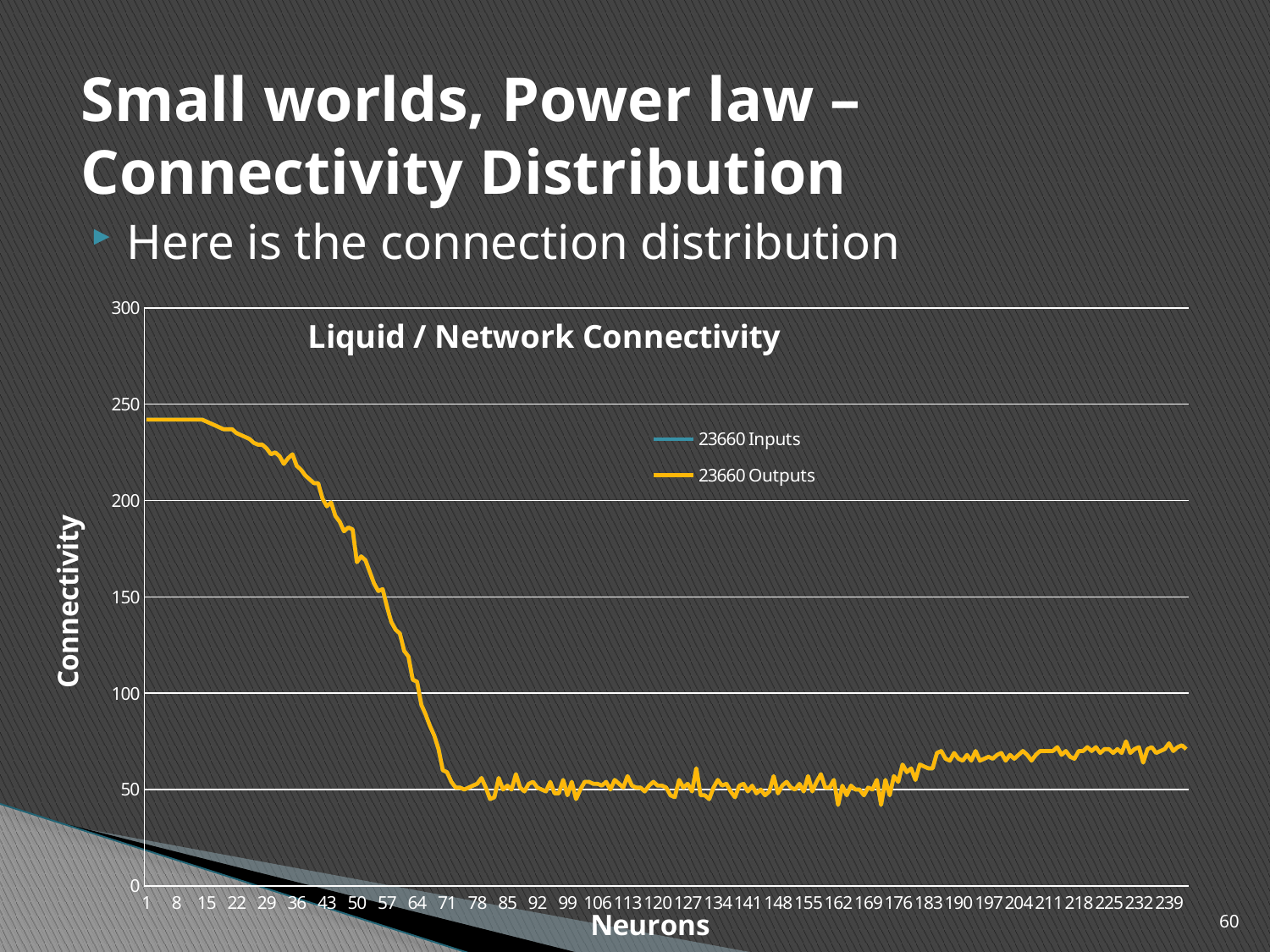
Which has the larger connectivity value, neuron 99 or neuron 239? neuron 239 What are the two series named in the chart legend? 23660 Inputs and 23660 Outputs Overall, do the plotted connectivity values rise or fall as the neuron number increases along the x axis? fall How many series does the chart legend list? 2 Is the connectivity value at neuron 99 greater or less than 100? less Is the connectivity value at neuron 50 greater or less than 150? greater Is the connectivity value at neuron 239 greater or less than 100? less Which has the larger connectivity value, neuron 1 or neuron 239? neuron 1 What is the title of the chart? Liquid / Network Connectivity What kind of chart is shown on the slide? line chart